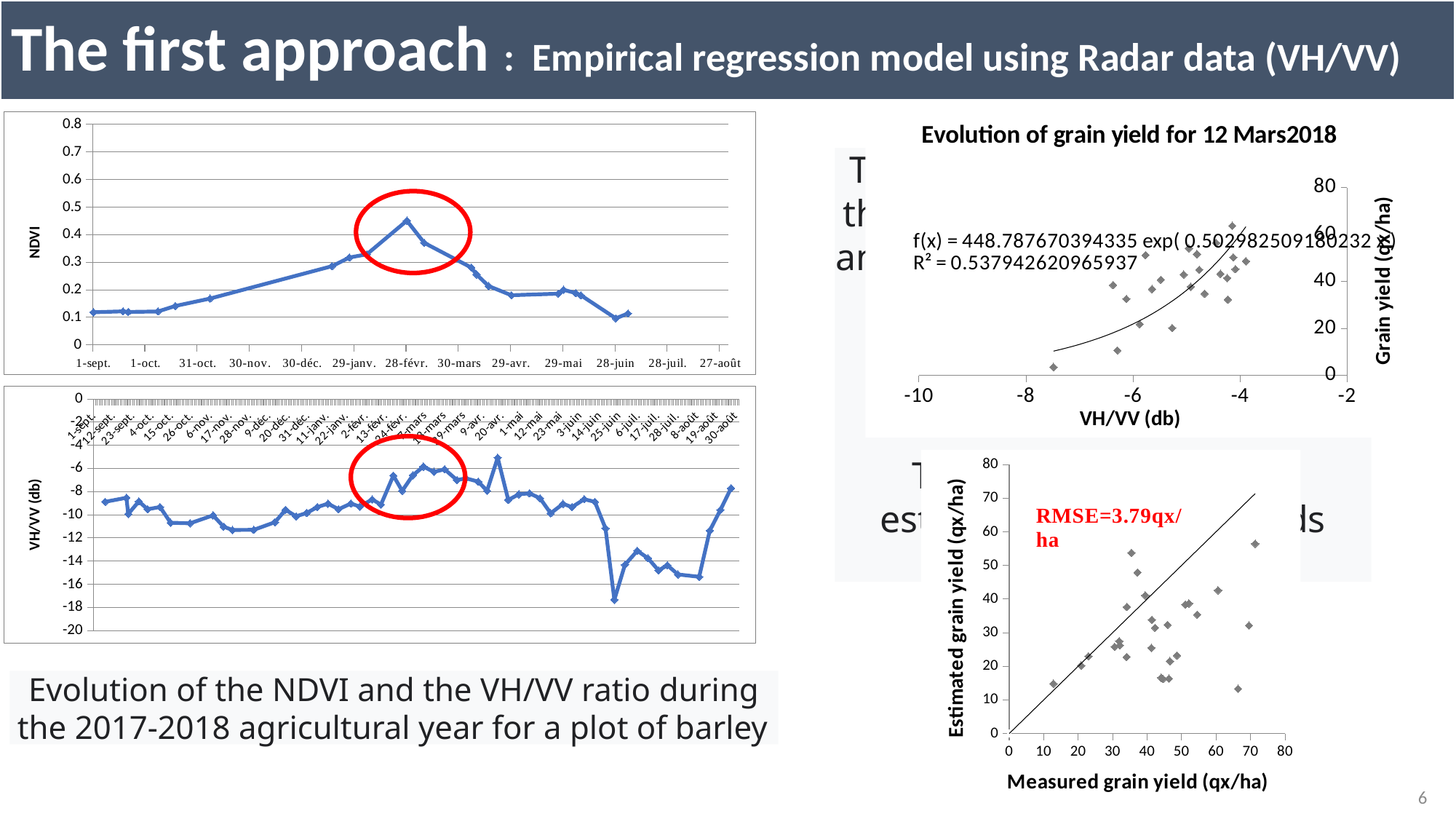
In the top-left NDVI chart, is the peak NDVI value near 28-févr. greater or less than 0.4? greater In the top-right chart, is the grain yield of the lowest point (at about -7.5 db) greater or less than 20? less What is the title of the top-right chart? Evolution of grain yield for 12 Mars2018 In the bottom-left VH/VV chart, does the VH/VV ratio rise or fall from 25-juin to 30-août? rise How many charts are shown on the slide? 4 In the bottom-left VH/VV chart, is the lowest VH/VV value (around 25-juin) greater or less than -16? less What kind of chart is the bottom-right chart of estimated versus measured grain yield? scatter chart What kind of chart is the top-left NDVI chart? line chart In the top-left NDVI chart, which is larger: the NDVI value at 28-févr. or at 1-sept.? 28-févr. In the top-left NDVI chart, does the NDVI rise or fall from 1-sept. to 28-févr.? rise What RMSE value is printed on the bottom-right chart? RMSE=3.79qx/ha